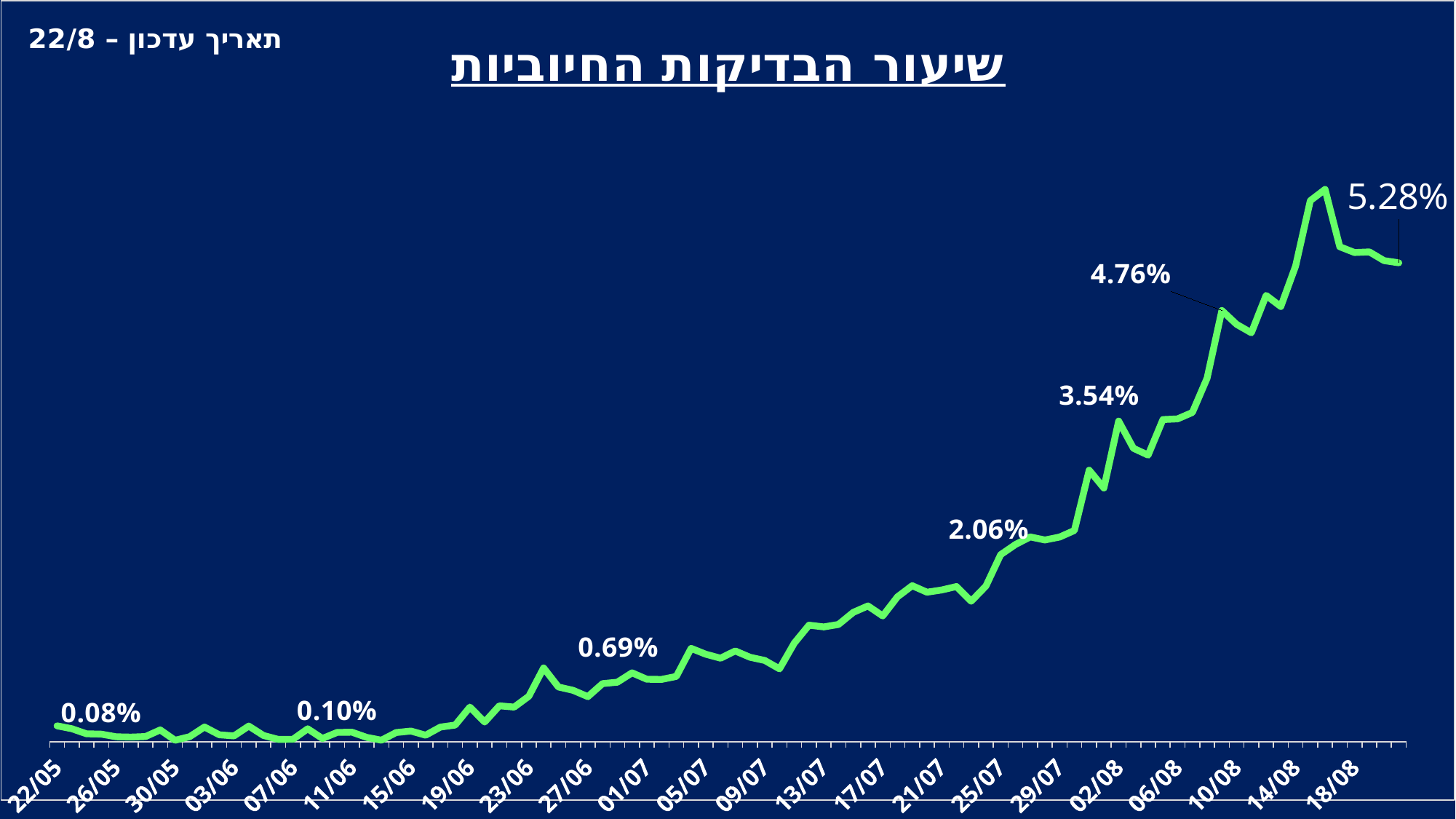
Which is larger: the last data point (5.28%) or the point labelled 4.76%? 5.28% How many date labels are shown along the x axis? 23 Overall, does the positive test rate rise or fall from 22/05 to the end of the period? rise What is the difference between the last data point (5.28%) and the first data point (0.08%)? 5.20% What is the value of the last data point on the line? 5.28% What is the value labelled at 10/08? 4.76% What type of chart is shown on the slide? line chart How many lines (series) are plotted on the chart? 1 What colour is the plotted line? green What is the difference between the points labelled 4.76% and 3.54%? 1.22% What is the title of the chart? שיעור הבדיקות החיוביות